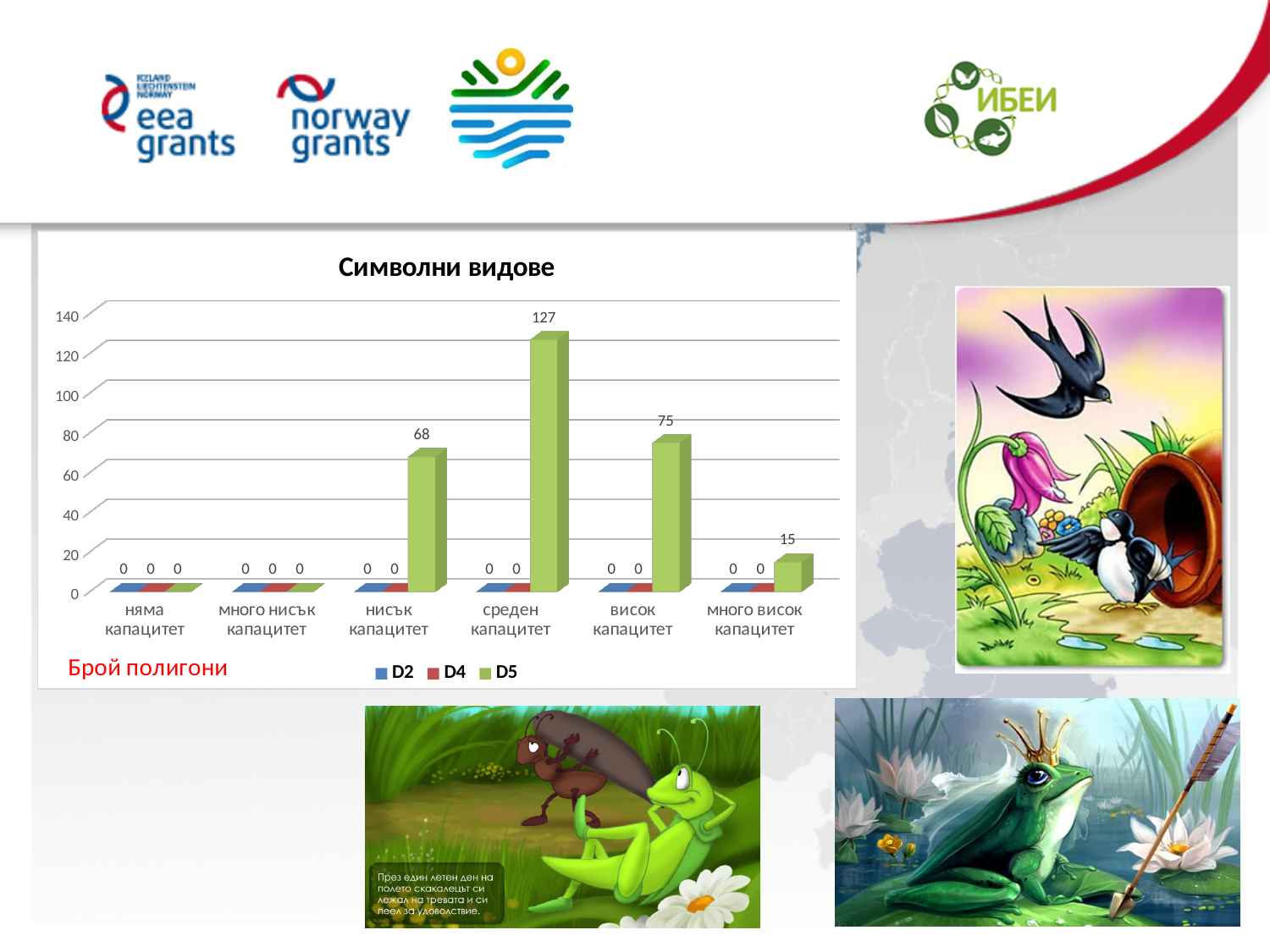
What is the D5 value for среден капацитет? 127 What is the D2 value for няма капацитет? 0 What is the difference between the D5 values for среден капацитет and висок капацитет? 52 What is the D5 value for много висок капацитет? 15 What label appears in red text at the bottom left of the chart? Брой полигони How many categories are shown on the x axis of the chart? 6 What is the D5 value for нисък капацитет? 68 What is the title of the chart? Символни видове What type of chart is shown on the slide? bar chart Which category has the highest D5 value? среден капацитет How many series does the chart legend list? 3 Which is larger, the D5 value for нисък капацитет or for висок капацитет? висок капацитет